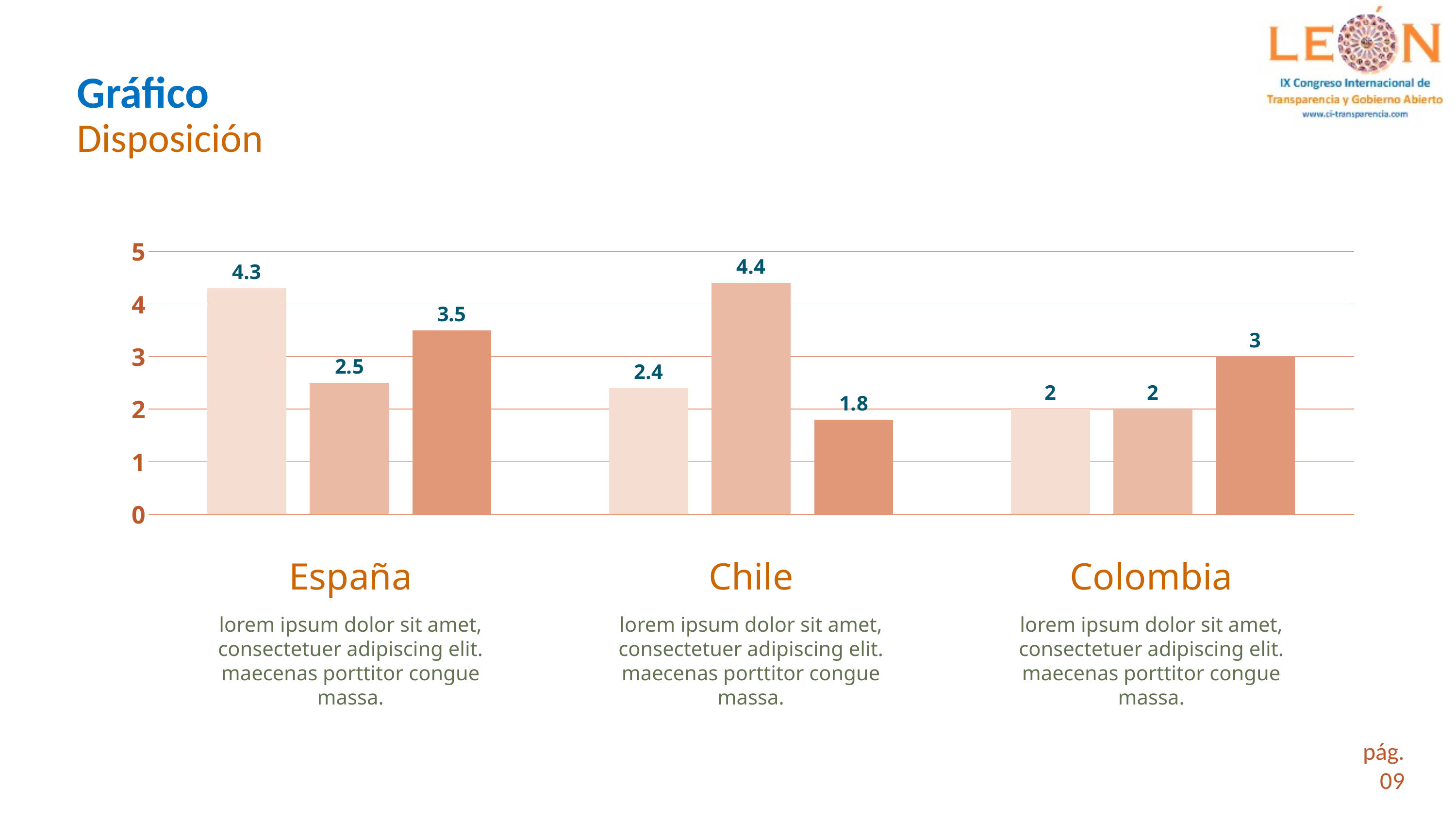
What is the value of the second bar for Chile? 4.4 What is the value of the first (lightest) bar for España? 4.3 Which bar has the lowest value in the whole chart? The third bar for Chile (1.8) Which bar has the highest value in the whole chart? The second bar for Chile (4.4) What is the value of the third (darkest) bar for Colombia? 3 Is the value of the third bar for España greater or less than 3? greater What is the subtitle of the chart shown under the heading 'Gráfico'? Disposición What is the value of the third (darkest) bar for Chile? 1.8 What kind of chart is shown on the slide? Bar chart What is the difference between the first and second bars for España? 1.8 Which is larger: the first bar for España or the second bar for Chile? The second bar for Chile How many categories are shown on the x axis? 3